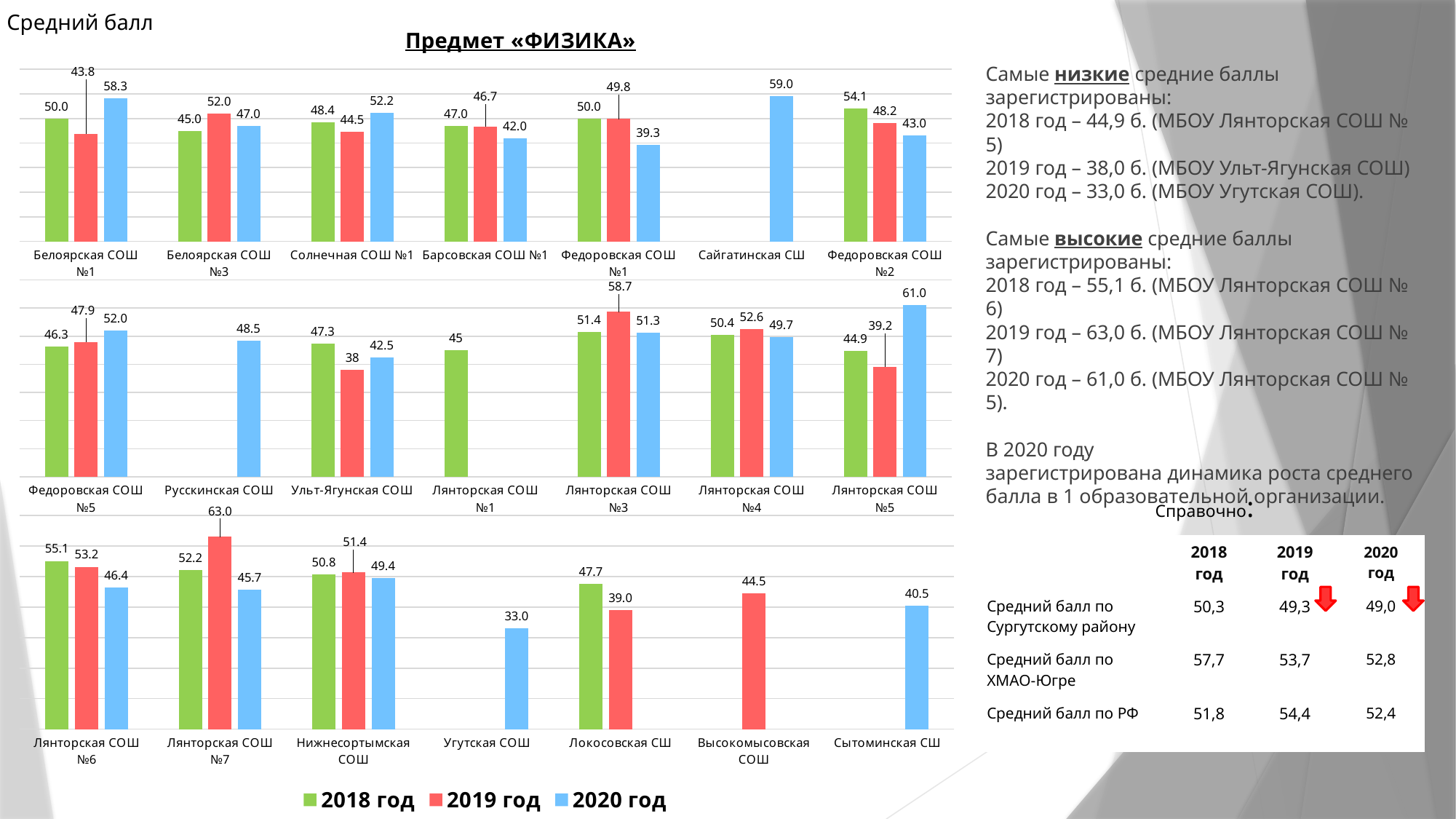
In the top chart, what is the 2020 год value for Белоярская СОШ №1? 58.3 How many series does the legend list? 3 What kind of chart is the top chart? bar chart In the top chart, what is the 2019 год value for Федоровская СОШ №1? 49.8 In the middle chart, what is the 2019 год value for Ульт-Ягунская СОШ? 38 In the bottom chart, which school has the lowest 2020 год value? Угутская СОШ In the top chart, which school has the highest 2020 год value? Сайгатинская СШ In the middle chart, which school has the highest 2020 год value? Лянторская СОШ №5 In the middle chart, which is larger for Лянторская СОШ №3: the 2019 год value or the 2020 год value? 2019 год In the bottom chart, do the values for Лянторская СОШ №6 rise or fall from 2018 год to 2020 год? fall In the top chart, what is the difference between the 2018 год and 2020 год values for Федоровская СОШ №2? 11.1 In the bottom chart, what is the 2019 год value for Лянторская СОШ №7? 63.0